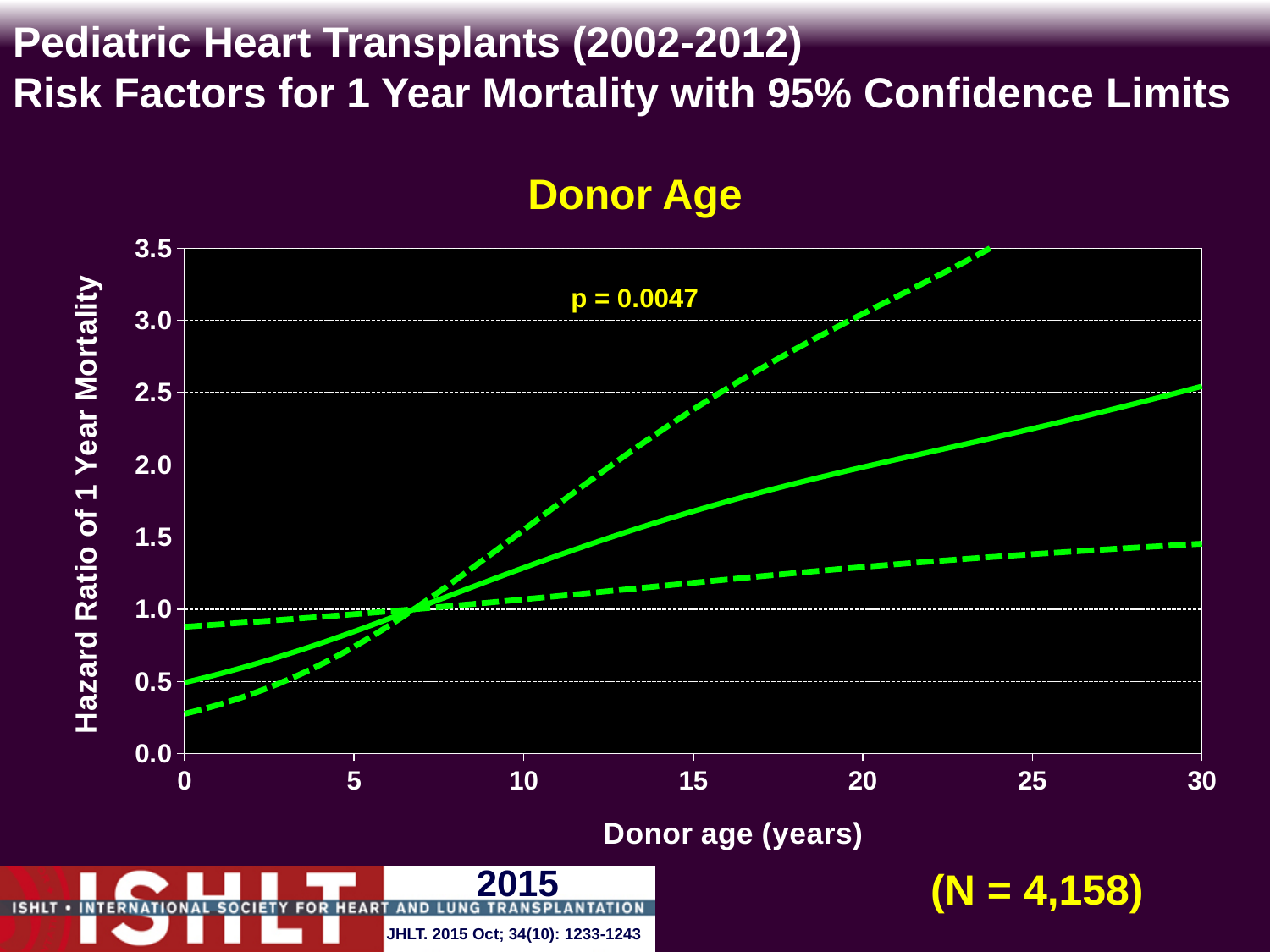
What p-value is printed on the chart? p = 0.0047 Is the lower dashed confidence limit at a donor age of 0 years greater or less than 0.5? less Is the hazard ratio on the solid line at a donor age of 15 years greater or less than 1.5? greater Is the lower dashed confidence limit at a donor age of 20 years greater or less than 1.0? greater What is the highest donor age shown on the x axis? 30 What sample size (N) is shown on the slide? N = 4,158 Does the solid hazard ratio line rise or fall as donor age increases from 0 to 30 years? rise How many lines are plotted on the chart? 3 What kind of chart is shown on the slide? line chart